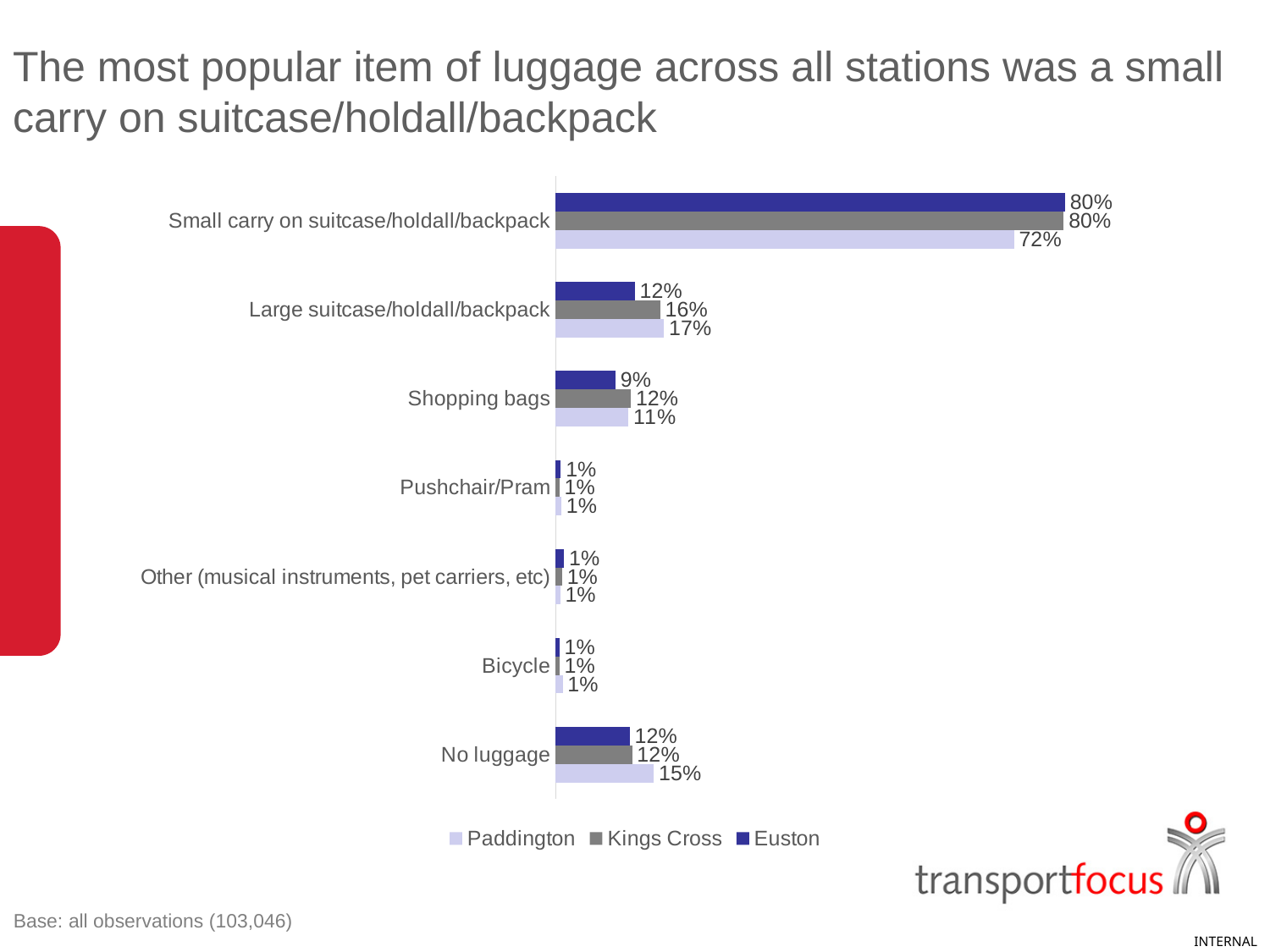
Which station is represented by the dark blue bars? Euston Which luggage category has the highest value for Euston? Small carry on suitcase/holdall/backpack How many luggage categories are shown on the chart? 7 What is the value for Kings Cross for Large suitcase/holdall/backpack? 16% What percentage of observations at Paddington had a small carry on suitcase/holdall/backpack? 72% What is the value for Euston for Shopping bags? 9% For Large suitcase/holdall/backpack, which station has the larger value, Euston or Paddington? Paddington What is the value for Paddington for No luggage? 15% What type of chart is shown on the slide? Bar chart How many series does the legend list? 3 For No luggage, which station has the larger value, Kings Cross or Paddington? Paddington What is the difference between the Kings Cross and Paddington values for Small carry on suitcase/holdall/backpack? 8%